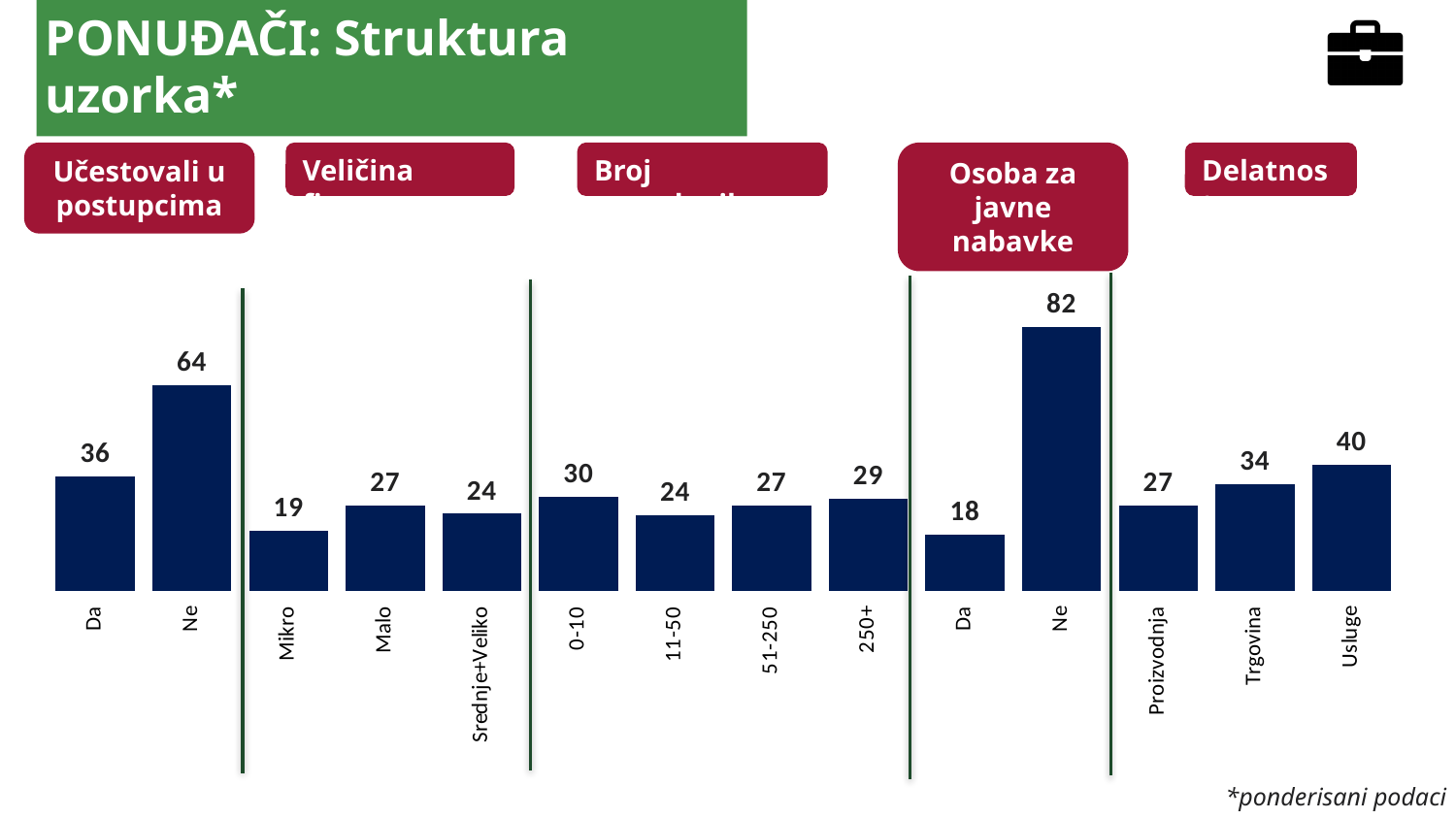
In the 'Osoba za javne nabavke' group, what is the value for Ne? 82 In the 'Učestovali u postupcima' group, what is the difference between Ne and Da? 28 Which bar has the highest value on the chart? Ne (Osoba za javne nabavke), 82 What kind of chart is shown on the slide? Bar chart What is the value for Mikro? 19 What is the value for the 250+ category? 29 Which is larger, Trgovina or Proizvodnja? Trgovina Which bar has the lowest value on the chart? Da (Osoba za javne nabavke), 18 How many bars are plotted on the chart? 14 Which is larger, 0-10 or 11-50? 0-10 What is the value for Usluge? 40 What is the title of the slide? PONUĐAČI: Struktura uzorka*